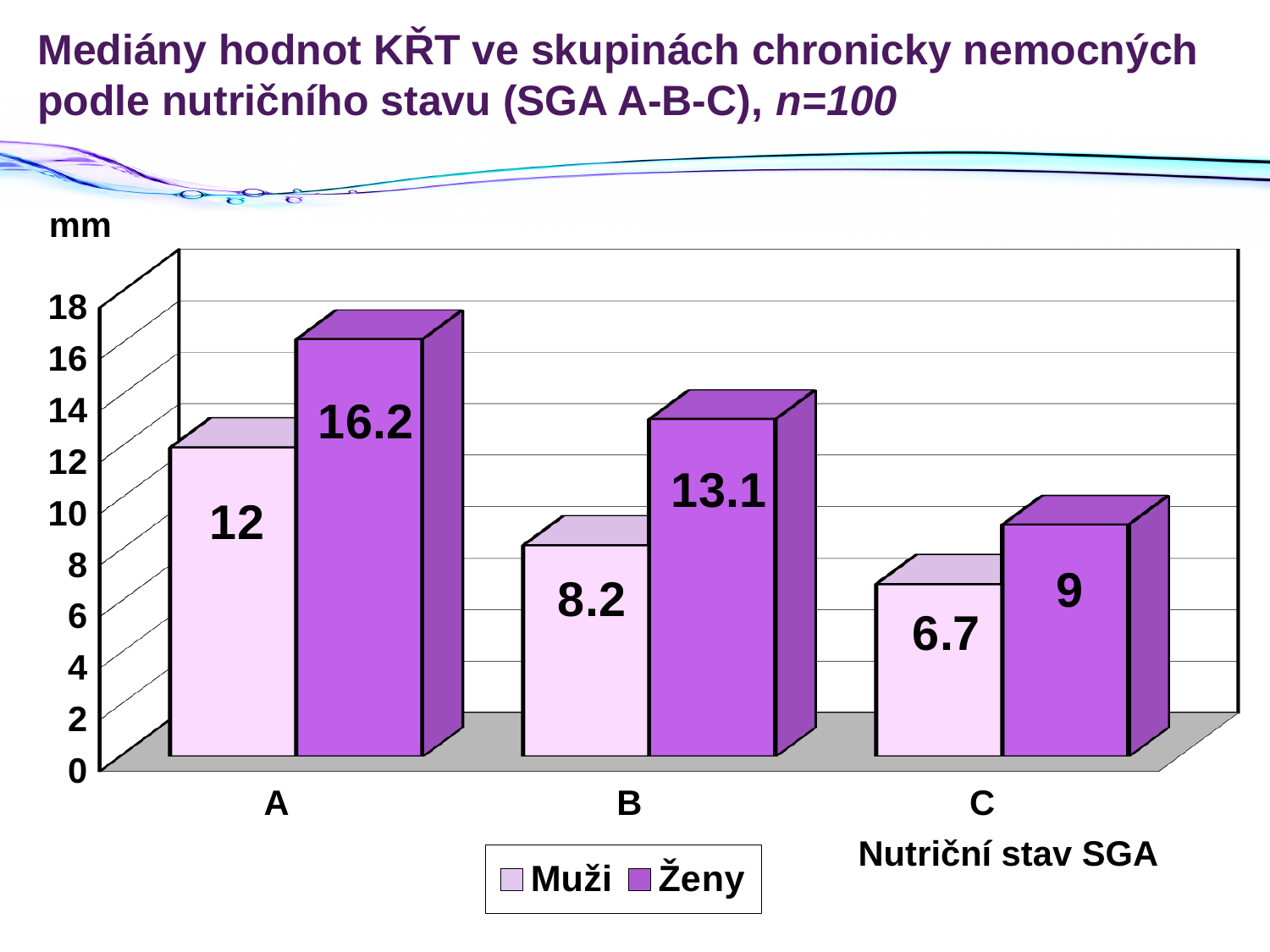
Which group has the lowest value for Muži? C What is the value for Ženy in group B? 13.1 Do the Muži values rise or fall from group A to group C? fall Which group has the highest value for Ženy? A What is the difference between the Ženy and Muži values in group A? 4.2 How many groups are shown on the x axis? 3 What is the value for Muži in group A? 12 What kind of chart is shown on the slide? bar chart How many series does the legend list? 2 What unit is shown on the y axis? mm What is the value for Muži in group C? 6.7 Which is larger in group C: the value for Muži or for Ženy? Ženy